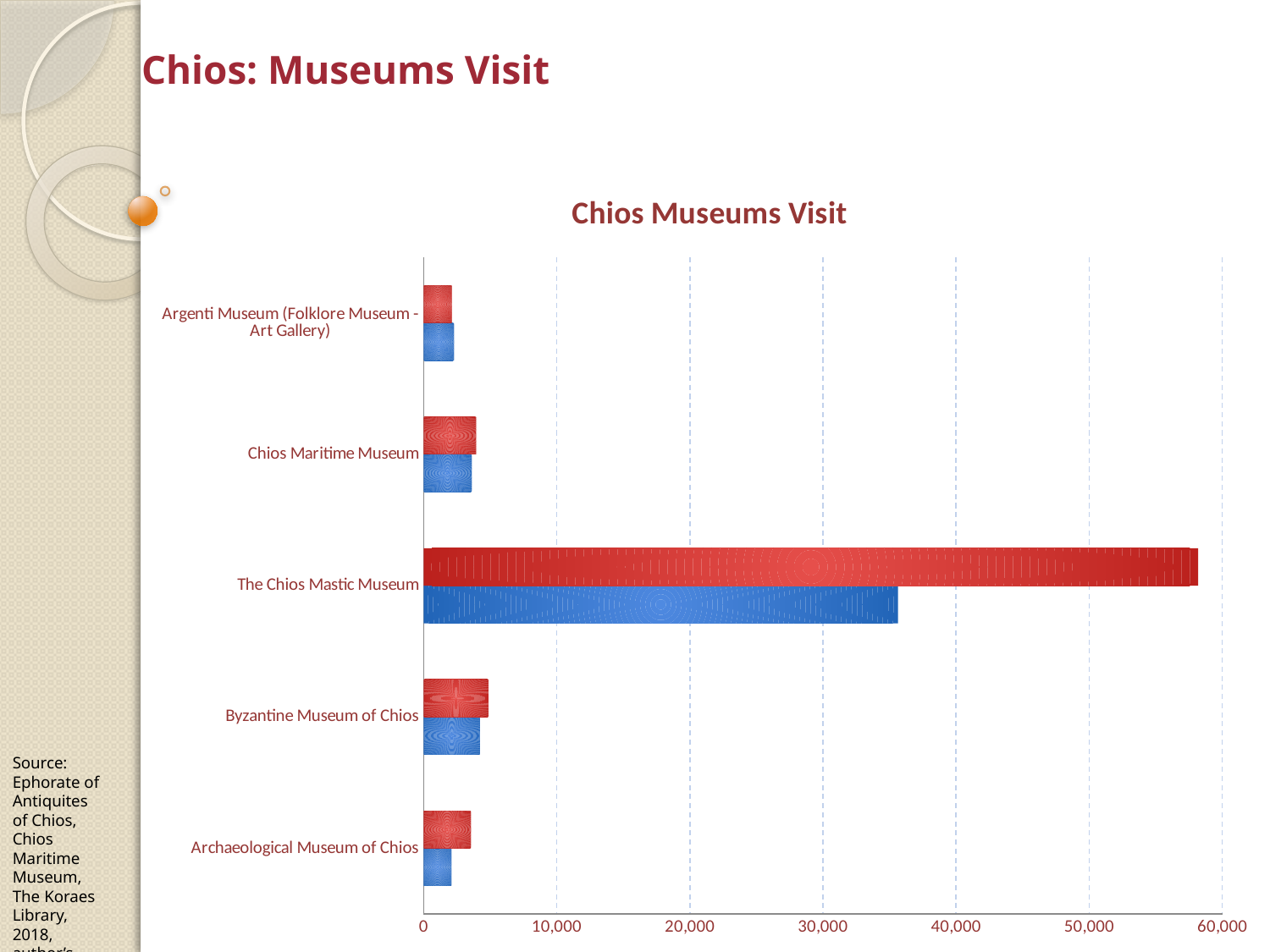
Is the red bar value for The Chios Mastic Museum greater or less than 50,000? greater Which museum has the highest number of visits on the chart? The Chios Mastic Museum Among the red bars, which museum has the lowest value? Argenti Museum (Folklore Museum - Art Gallery) Is the red bar value for Byzantine Museum of Chios greater or less than 10,000? less For The Chios Mastic Museum, which bar is larger, the red one or the blue one? The red one For Archaeological Museum of Chios, which bar is larger, the red one or the blue one? The red one Is the blue bar value for The Chios Mastic Museum greater or less than 40,000? less How many bars are plotted for each museum on the chart? 2 How many museums (categories) are plotted on the chart? 5 What kind of chart is shown on the slide? Bar chart What is the title of the chart? Chios Museums Visit